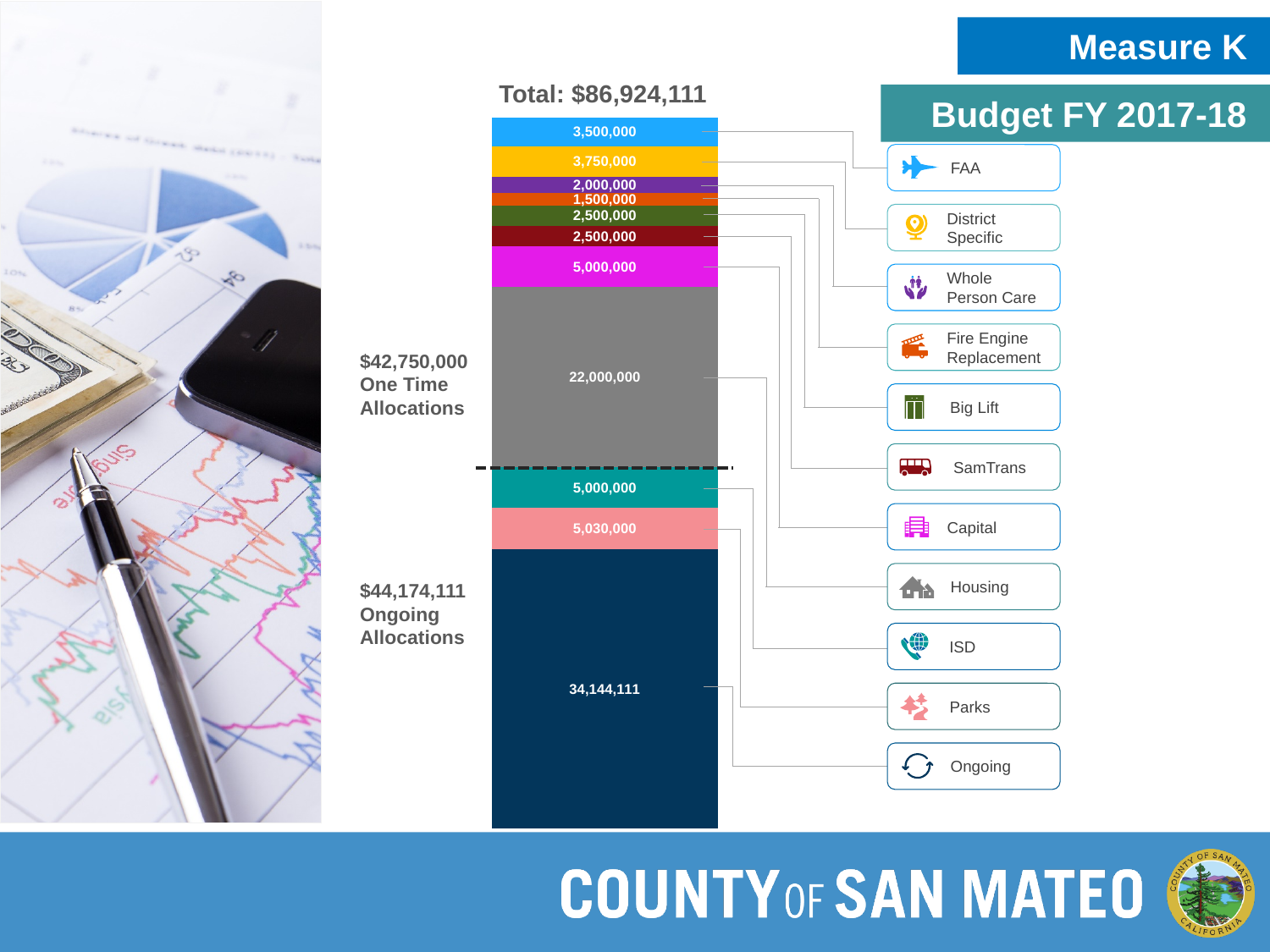
What is the total shown above the stacked bar? $86,924,111 Which segment of the stacked bar has the largest value? Ongoing How many segments make up the stacked bar? 11 Which is larger, the FAA value or the District Specific value? District Specific What fiscal year does the budget title on the slide refer to? FY 2017-18 What kind of chart is shown on the slide? Stacked bar chart Which segment of the stacked bar has the smallest value? Fire Engine Replacement What is the total for One Time Allocations shown beside the bar? $42,750,000 What value is shown for the Ongoing segment? 34,144,111 What is the difference between the Parks value and the ISD value? 30,000 What value is shown for the Housing segment? 22,000,000 What value is shown for the Fire Engine Replacement segment? 1,500,000